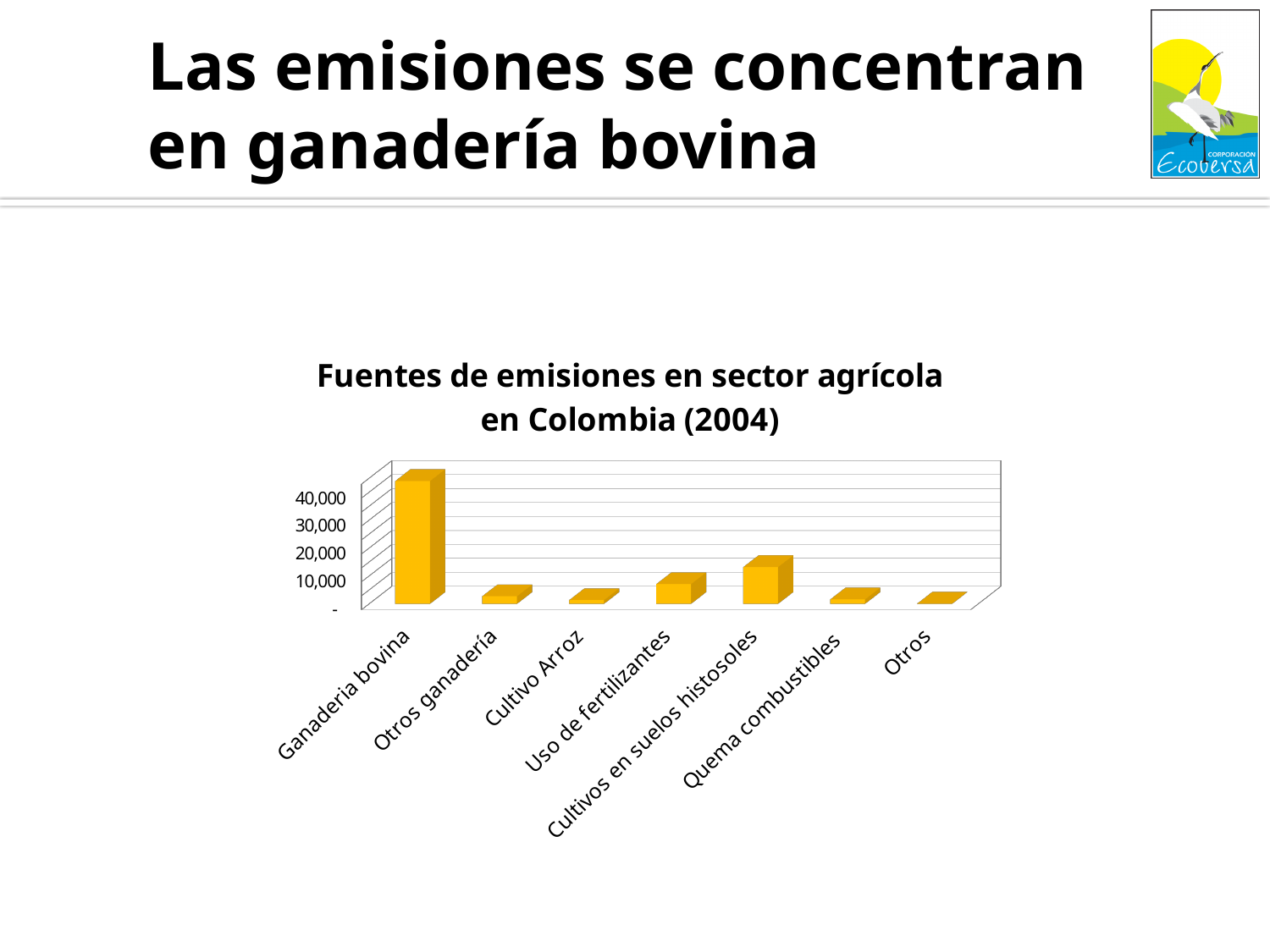
Which is larger, the value for Ganaderia bovina or the value for Cultivos en suelos histosoles? Ganaderia bovina Is the value for Ganaderia bovina greater or less than 40,000? greater Is the value for Cultivos en suelos histosoles greater or less than 10,000? greater Which is larger, the value for Uso de fertilizantes or the value for Otros ganadería? Uso de fertilizantes What kind of chart is shown on the slide? bar chart Which category has the highest value in the chart? Ganaderia bovina Which is larger, the value for Cultivos en suelos histosoles or the value for Uso de fertilizantes? Cultivos en suelos histosoles How many categories are shown on the x axis of the chart? 7 Is the value for Cultivos en suelos histosoles greater or less than 20,000? less What is the title of the chart? Fuentes de emisiones en sector agrícola en Colombia (2004)